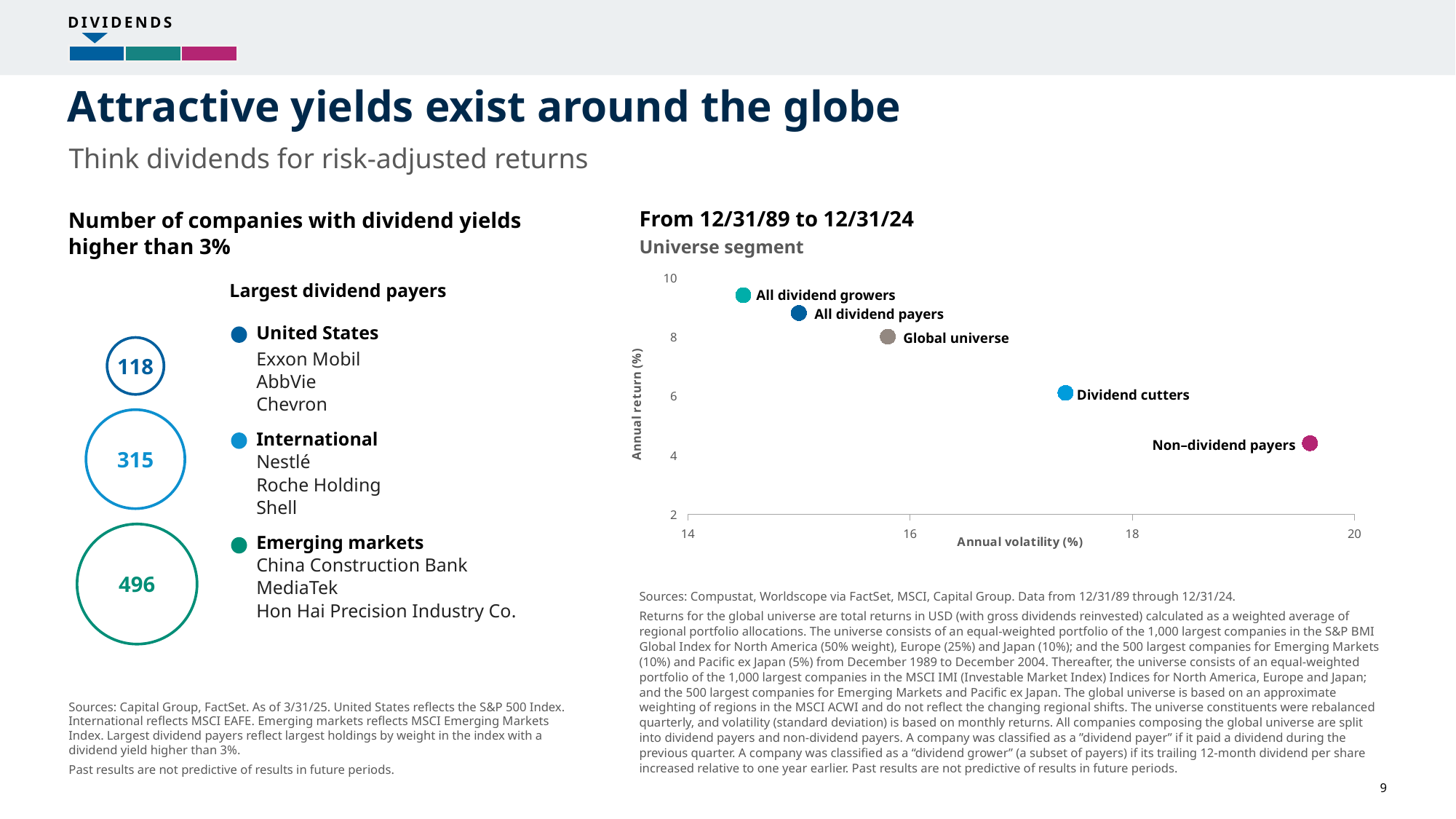
On the 'Universe segment' chart, which segment has the lowest annual return? Non–dividend payers On the 'Universe segment' chart, which segment has the highest annual return? All dividend growers In the 'Number of companies with dividend yields higher than 3%' graphic on the left, how many companies are shown for Emerging markets? 496 In the 'Number of companies with dividend yields higher than 3%' graphic on the left, what is the difference between the Emerging markets and United States counts? 378 On the 'Universe segment' chart, is the annual return for All dividend growers greater or less than 8%? greater On the 'Universe segment' chart, which segment has the highest annual volatility? Non–dividend payers On the 'Universe segment' chart, as annual volatility increases along the x axis, do annual returns rise or fall? fall On the 'Universe segment' chart, is the annual return for Non–dividend payers greater or less than 6%? less What type of chart is the 'Universe segment' chart on the right of the slide? Scatter chart In the 'Number of companies with dividend yields higher than 3%' graphic on the left, which region has the fewest companies? United States How many data points are plotted on the 'Universe segment' scatter chart? 5 On the 'Universe segment' chart, is the annual volatility for Dividend cutters greater or less than 16%? greater